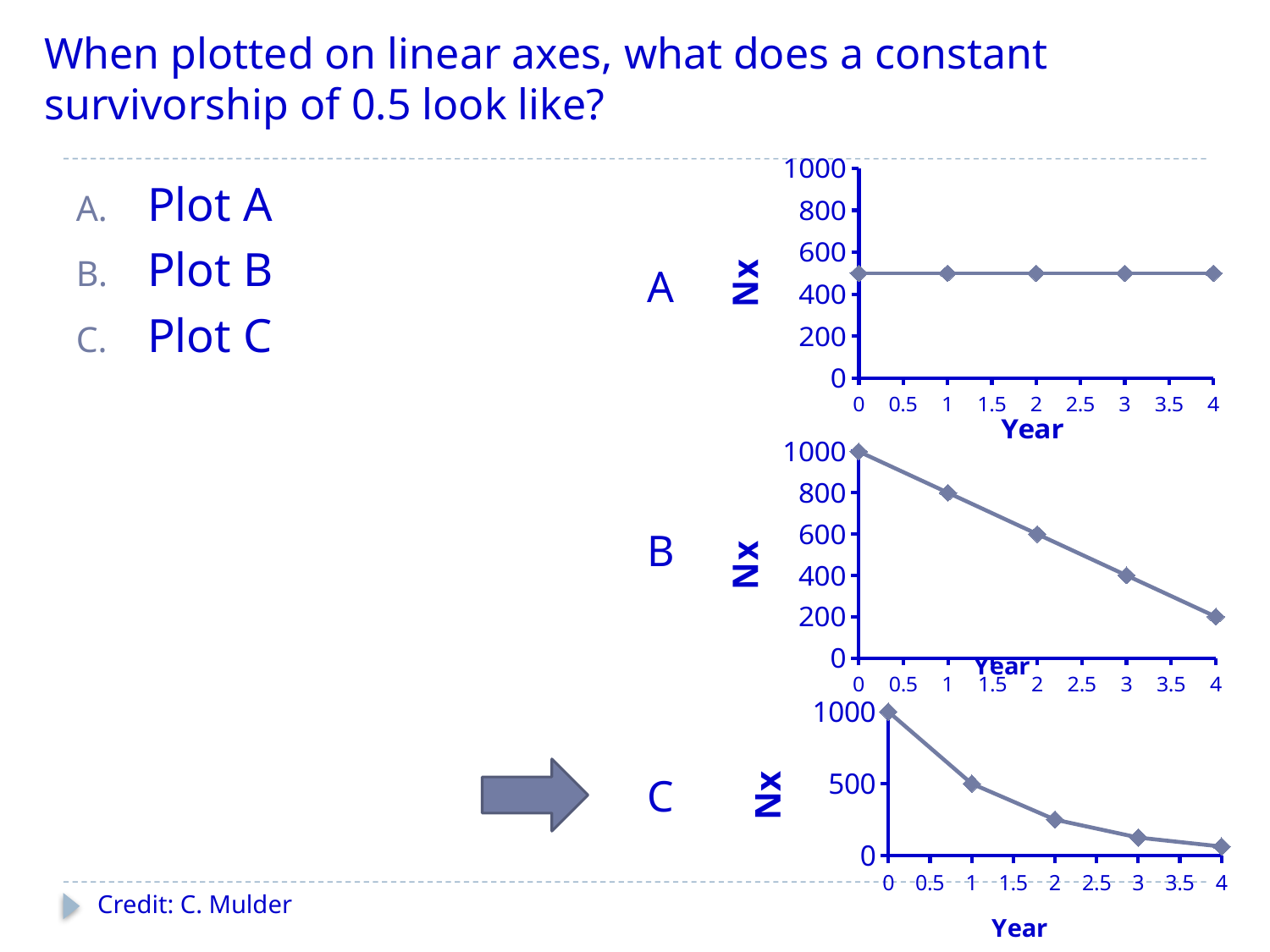
In Plot B, do the Nx values rise, fall, or stay flat as the year increases? Fall In Plot C, what is the difference between Nx at year 0 and Nx at year 1? 500 In Plot C, is the value of Nx at year 3 greater or less than 500? less In Plot B, which year has the higher Nx value, year 1 or year 3? Year 1 In Plot C, what is the value of Nx at year 1? 500 In Plot B, what is the value of Nx at year 0? 1000 In Plot A, is the value of Nx at year 2 greater or less than 400? greater In Plot B, what is the difference between Nx at year 0 and Nx at year 4? 800 What kind of chart is Plot A? Line chart In Plot B, what is the value of Nx at year 2? 600 How many data points are plotted in Plot C? 5 In Plot B, what is the value of Nx at year 4? 200